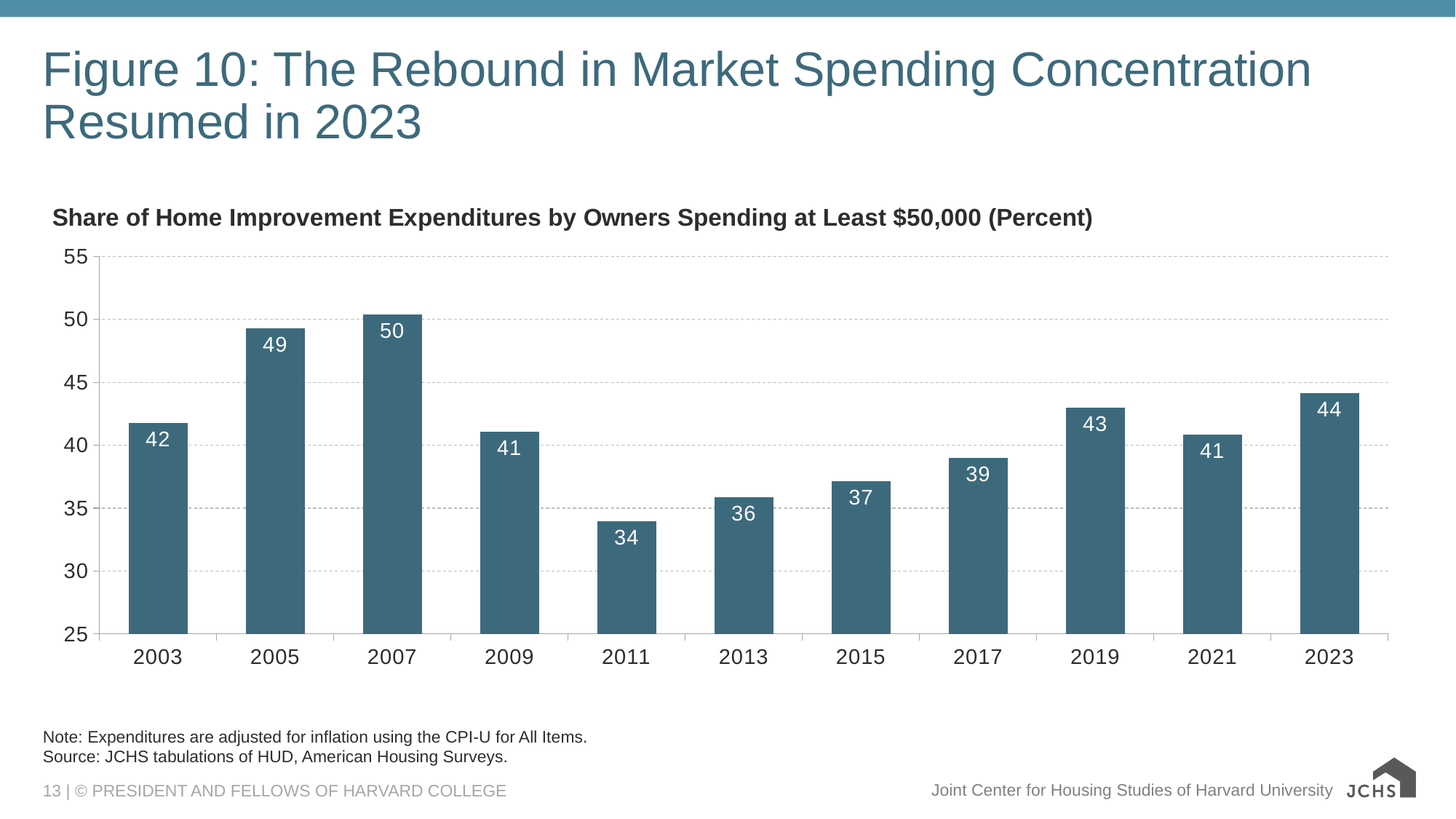
What value is shown for 2005? 49 What is the share of home improvement expenditures by owners spending at least $50,000 in 2023? 44 Which year has the lowest share? 2011 What is the difference between the values for 2023 and 2021? 3 What is the difference between the values for 2007 and 2011? 16 Do the values rise or fall from 2011 to 2019? rise What kind of chart is this? bar chart How many years are shown on the x axis? 11 Is the value for 2013 greater or less than 40? less Which year has the highest share? 2007 What value is shown for 2011? 34 Which is larger, the value for 2019 or the value for 2017? 2019